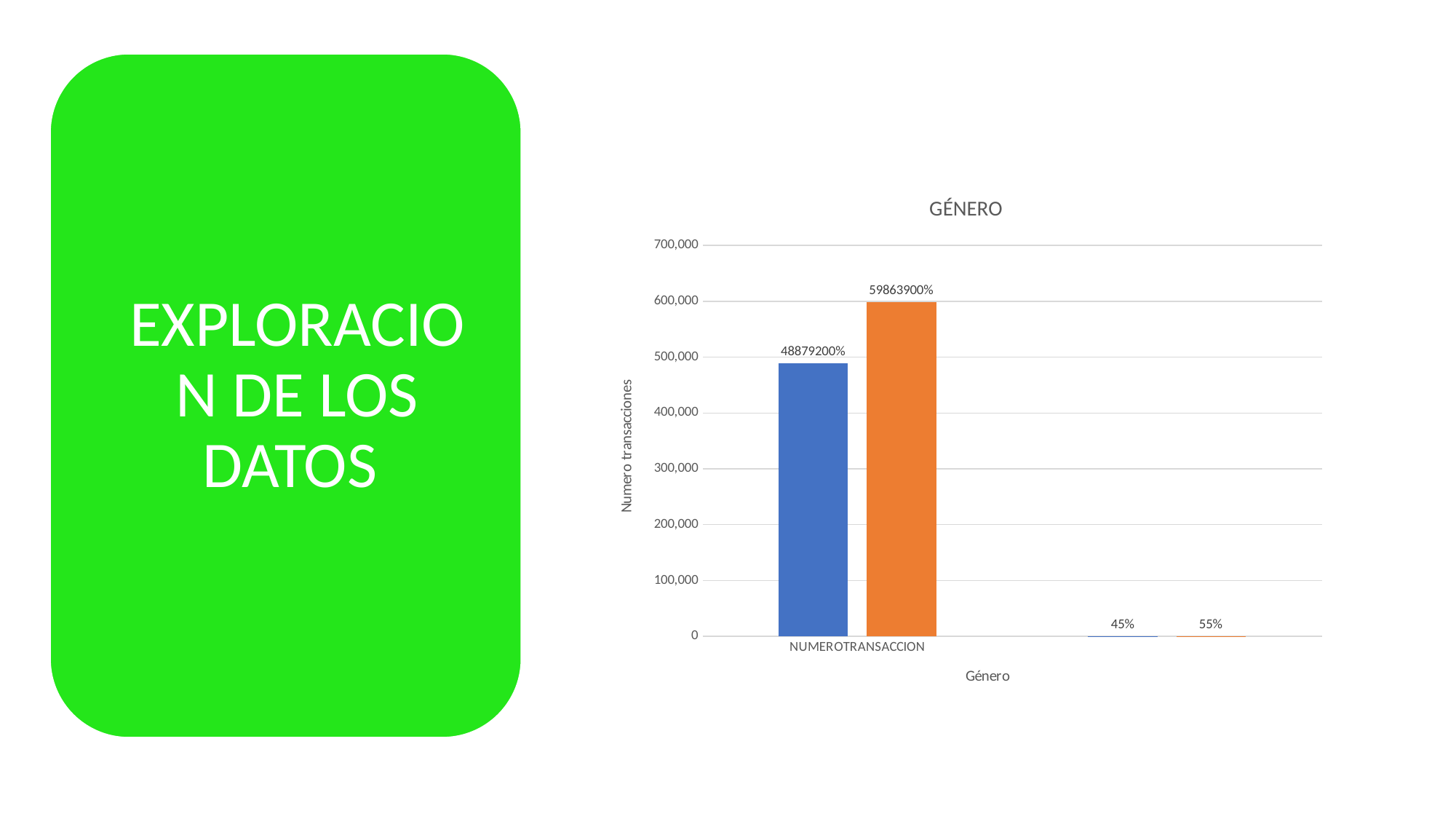
What kind of chart is shown on the slide? bar chart What value is printed above the orange bar for NUMEROTRANSACCION? 59863900% What value is printed above the blue bar for NUMEROTRANSACCION? 48879200% How many bars are plotted in the NUMEROTRANSACCION group? 2 Is the blue bar for NUMEROTRANSACCION greater or less than 400,000 on the y axis? greater Is the orange bar for NUMEROTRANSACCION greater or less than 500,000 on the y axis? greater For NUMEROTRANSACCION, which bar is taller, the blue one or the orange one? orange What is the title of the chart? GÉNERO How many category groups are shown along the x axis? 2 What is the label of the vertical axis? Numero transacciones Which bar is the highest in the chart? the orange bar for NUMEROTRANSACCION What is the difference between the orange bar label and the blue bar label for NUMEROTRANSACCION? 10984700%